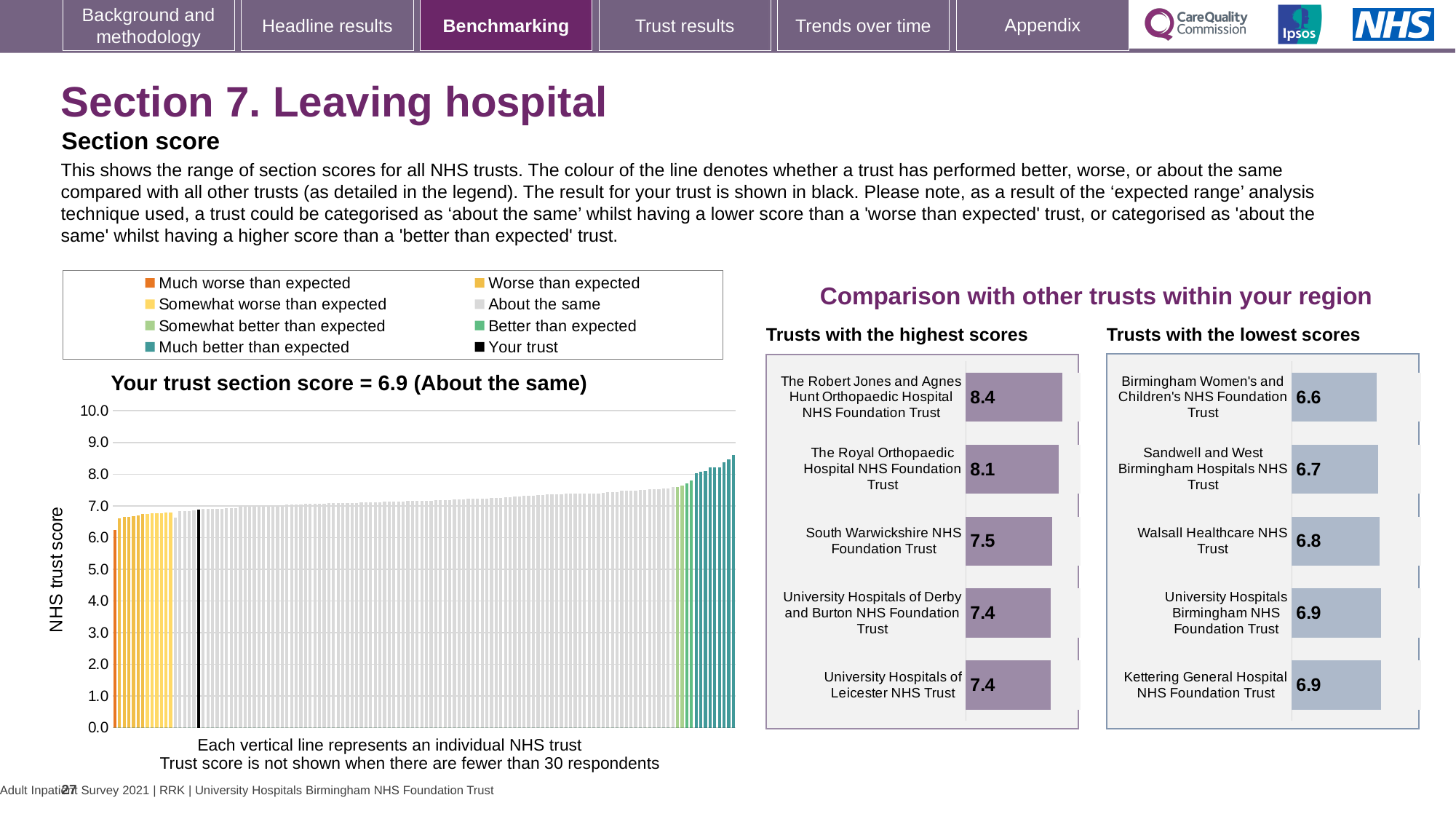
In the 'Trusts with the highest scores' chart, what is the score for South Warwickshire NHS Foundation Trust? 7.5 In the 'Trusts with the lowest scores' chart, which trust has the lowest score? Birmingham Women's and Children's NHS Foundation Trust In the 'Trusts with the lowest scores' chart, what is the score for Birmingham Women's and Children's NHS Foundation Trust? 6.6 In the main chart on the left, do the bar values rise or fall from left to right along the x axis? rise In the main chart on the left, is the value of the tallest bar greater or less than 8.0? greater In the 'Trusts with the lowest scores' chart, which has the larger score: Sandwell and West Birmingham Hospitals NHS Trust or Kettering General Hospital NHS Foundation Trust? Kettering General Hospital NHS Foundation Trust In the 'Trusts with the highest scores' chart, which trust has the highest score? The Robert Jones and Agnes Hunt Orthopaedic Hospital NHS Foundation Trust How many trusts are shown in the 'Trusts with the highest scores' chart? 5 In the main chart on the left, what is your trust's section score? 6.9 In the 'Trusts with the highest scores' chart, what is the difference between the scores of The Robert Jones and Agnes Hunt Orthopaedic Hospital NHS Foundation Trust and South Warwickshire NHS Foundation Trust? 0.9 In the 'Trusts with the highest scores' chart, what is the score for The Robert Jones and Agnes Hunt Orthopaedic Hospital NHS Foundation Trust? 8.4 In the 'Trusts with the lowest scores' chart, what is the score for Walsall Healthcare NHS Trust? 6.8